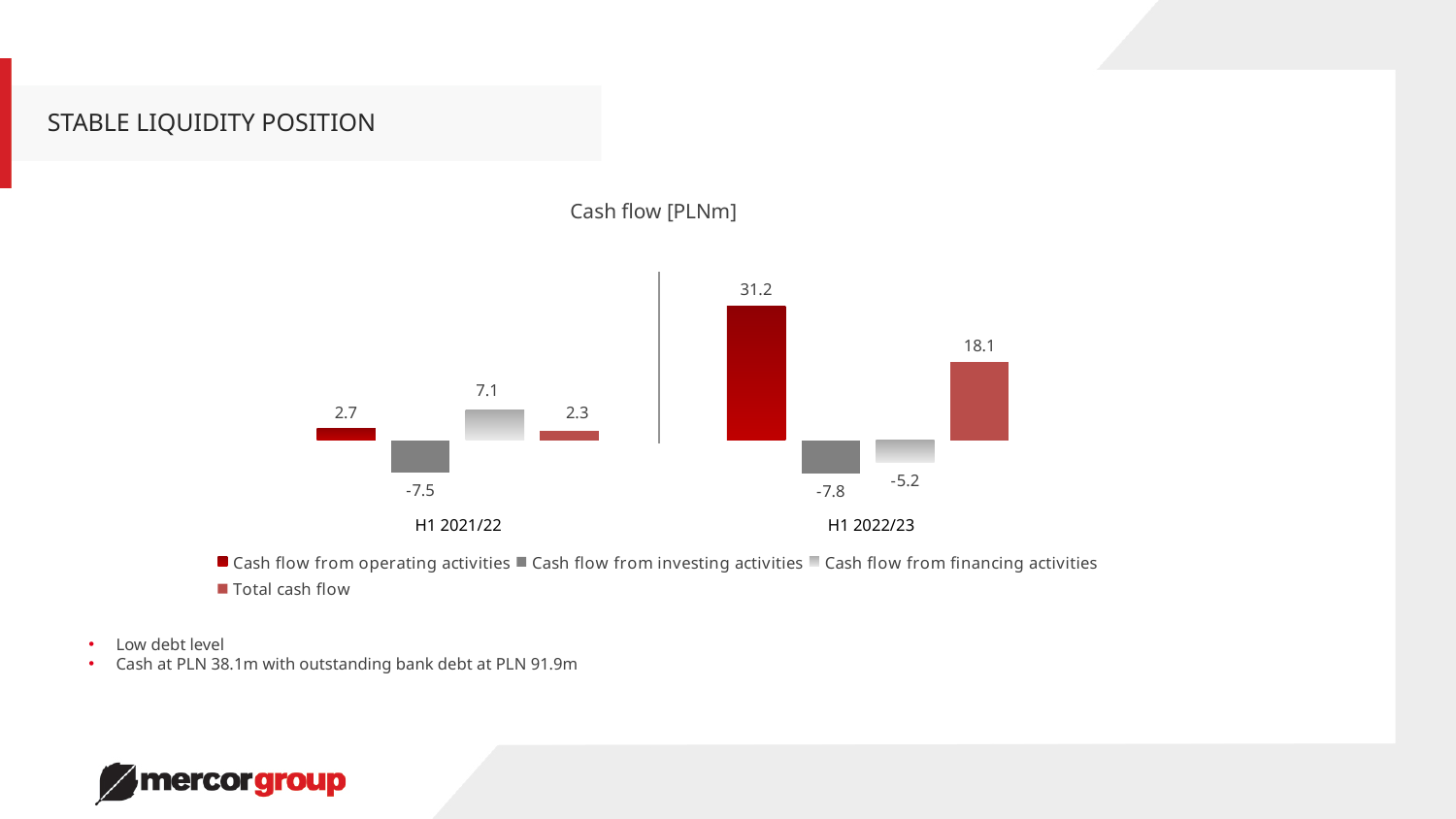
What is the difference between cash flow from operating activities in H1 2022/23 and H1 2021/22? 28.5 What is the cash flow from operating activities for H1 2022/23? 31.2 What is the title of the chart? Cash flow [PLNm] Which series has the lowest value in H1 2022/23? Cash flow from investing activities Which period has the higher cash flow from operating activities? H1 2022/23 How many series does the legend list? 4 What is the cash flow from financing activities for H1 2021/22? 7.1 How many periods are shown on the x axis? 2 What is the cash flow from investing activities for H1 2022/23? -7.8 What is the total cash flow for H1 2021/22? 2.3 What kind of chart is shown on the slide? Bar chart What is the difference in total cash flow between H1 2022/23 and H1 2021/22? 15.8